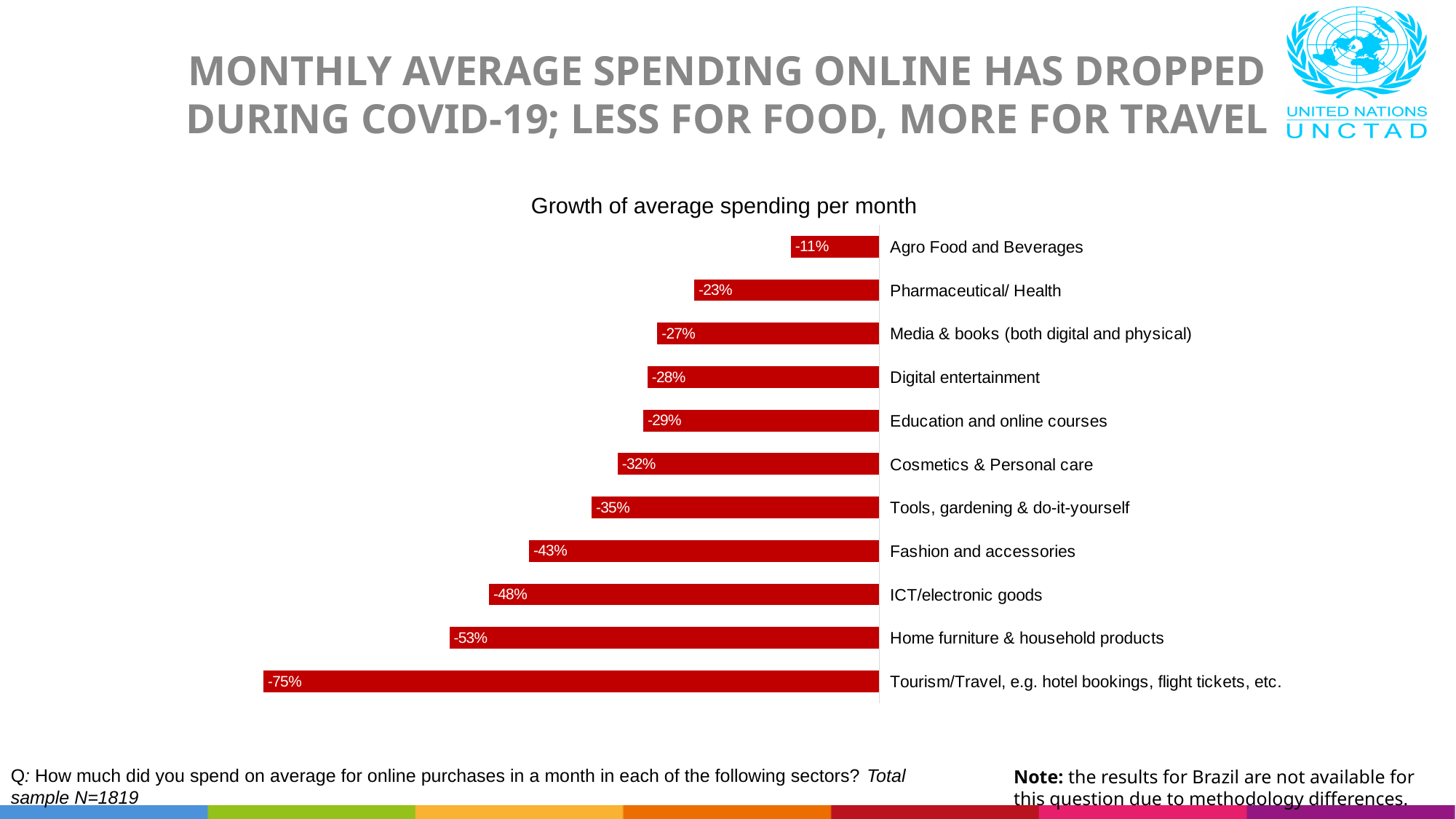
What colour are the bars in the chart? Red What is the value shown for ICT/electronic goods? -48% How many categories are shown in the chart? 11 What is the value shown for Education and online courses? -29% Which category shows the smallest drop in average spending per month? Agro Food and Beverages Which category shows the largest drop in average spending per month? Tourism/Travel, e.g. hotel bookings, flight tickets, etc. What is the title of the chart? Growth of average spending per month Which category has a larger drop: Cosmetics & Personal care or Digital entertainment? Cosmetics & Personal care What kind of chart is shown on the slide? Bar chart What is the difference between the values for Home furniture & household products and Fashion and accessories? 10 percentage points What is the value shown for Pharmaceutical/ Health? -23% What is the growth of average spending per month for Tourism/Travel, e.g. hotel bookings, flight tickets, etc.? -75%